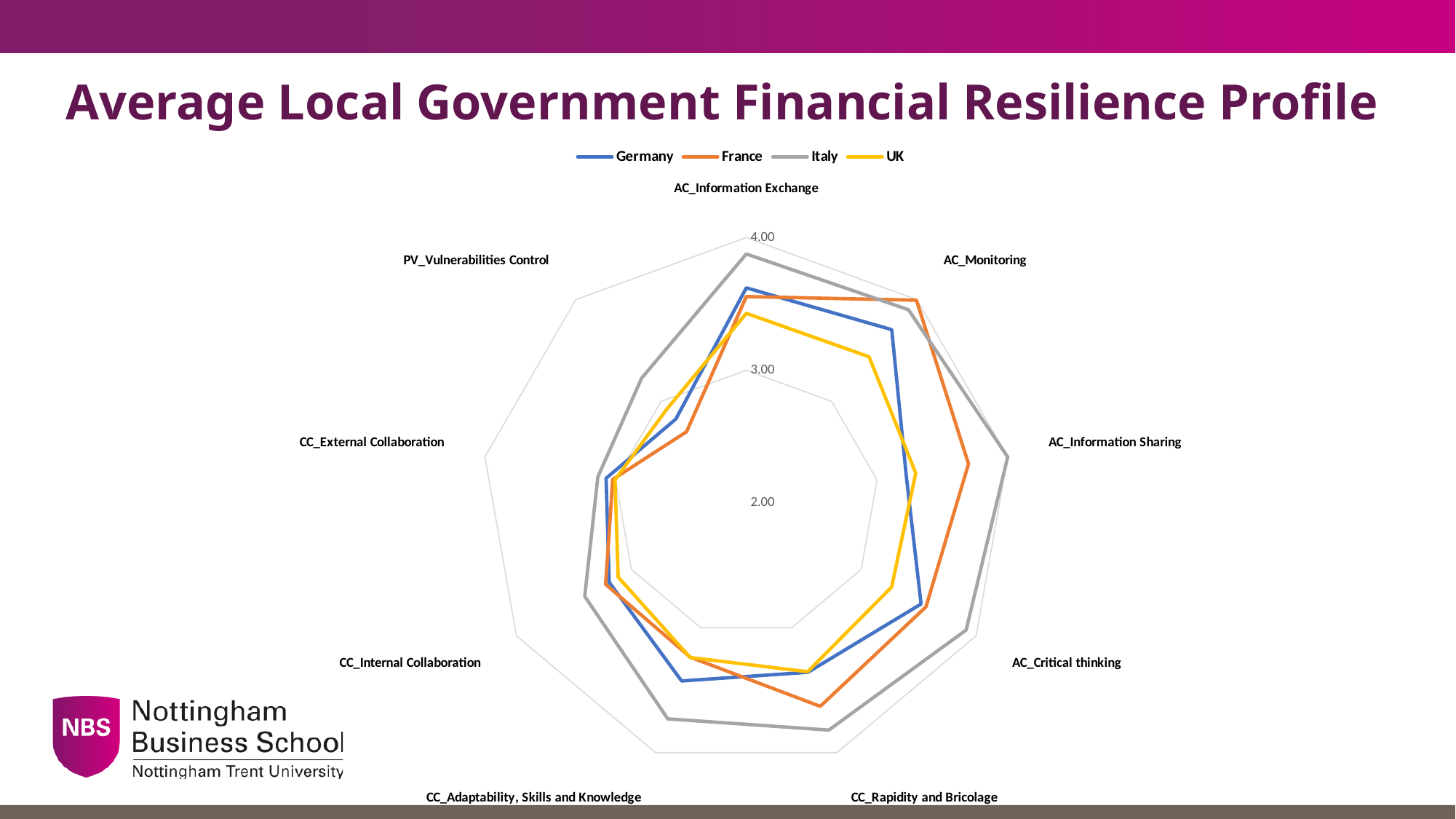
Which country has the lowest value for AC_Critical thinking? UK Which country has the highest value for CC_Rapidity and Bricolage? Italy Which country has the lowest value for AC_Monitoring? UK How many categories (axes) does the radar chart have? 9 Which is larger for AC_Information Sharing: France or Germany? France What is the title of the chart? Average Local Government Financial Resilience Profile Is the value for Germany on AC_Information Exchange greater or less than 3.00? greater Which country is plotted with the grey line? Italy Is the value for France on CC_Rapidity and Bricolage greater or less than 3.00? greater How many series does the legend list? 4 Which country has the highest value for AC_Information Sharing? Italy What kind of chart is shown on the slide? Radar chart